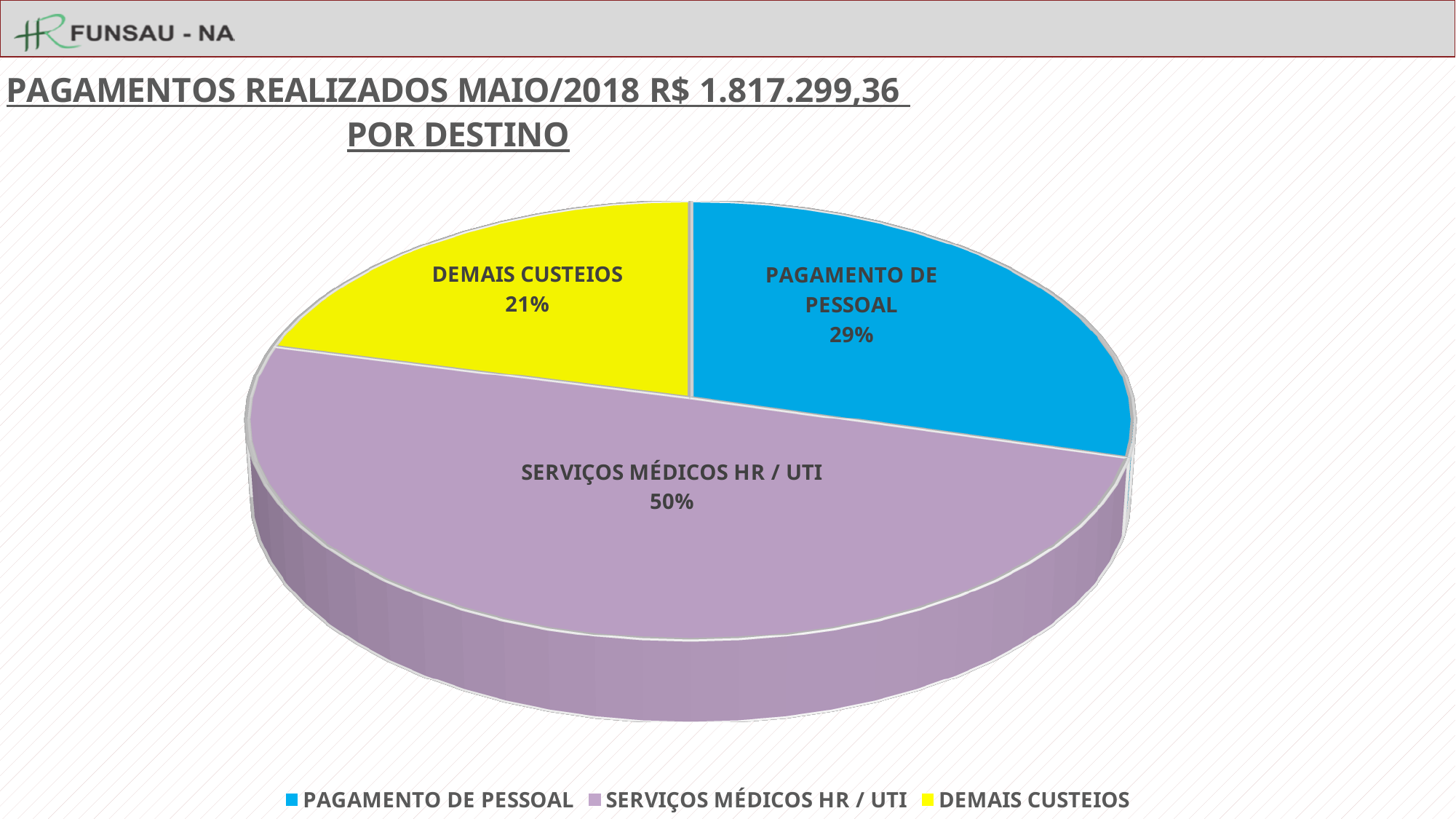
What share of the pie does SERVIÇOS MÉDICOS HR / UTI represent? 50% What is the difference in percentage points between PAGAMENTO DE PESSOAL and DEMAIS CUSTEIOS? 8 percentage points Which is larger, the share for PAGAMENTO DE PESSOAL or the share for DEMAIS CUSTEIOS? PAGAMENTO DE PESSOAL What colour is the slice for DEMAIS CUSTEIOS? Yellow Which category has the smallest slice of the pie? DEMAIS CUSTEIOS What is the difference in percentage points between SERVIÇOS MÉDICOS HR / UTI and PAGAMENTO DE PESSOAL? 21 percentage points What is the title of the chart? PAGAMENTOS REALIZADOS MAIO/2018 R$ 1.817.299,36 POR DESTINO What share of the pie does DEMAIS CUSTEIOS represent? 21% What share of the pie does PAGAMENTO DE PESSOAL represent? 29% What kind of chart is shown on the slide? Pie chart Which category has the largest slice of the pie? SERVIÇOS MÉDICOS HR / UTI How many categories are shown in the pie chart? 3